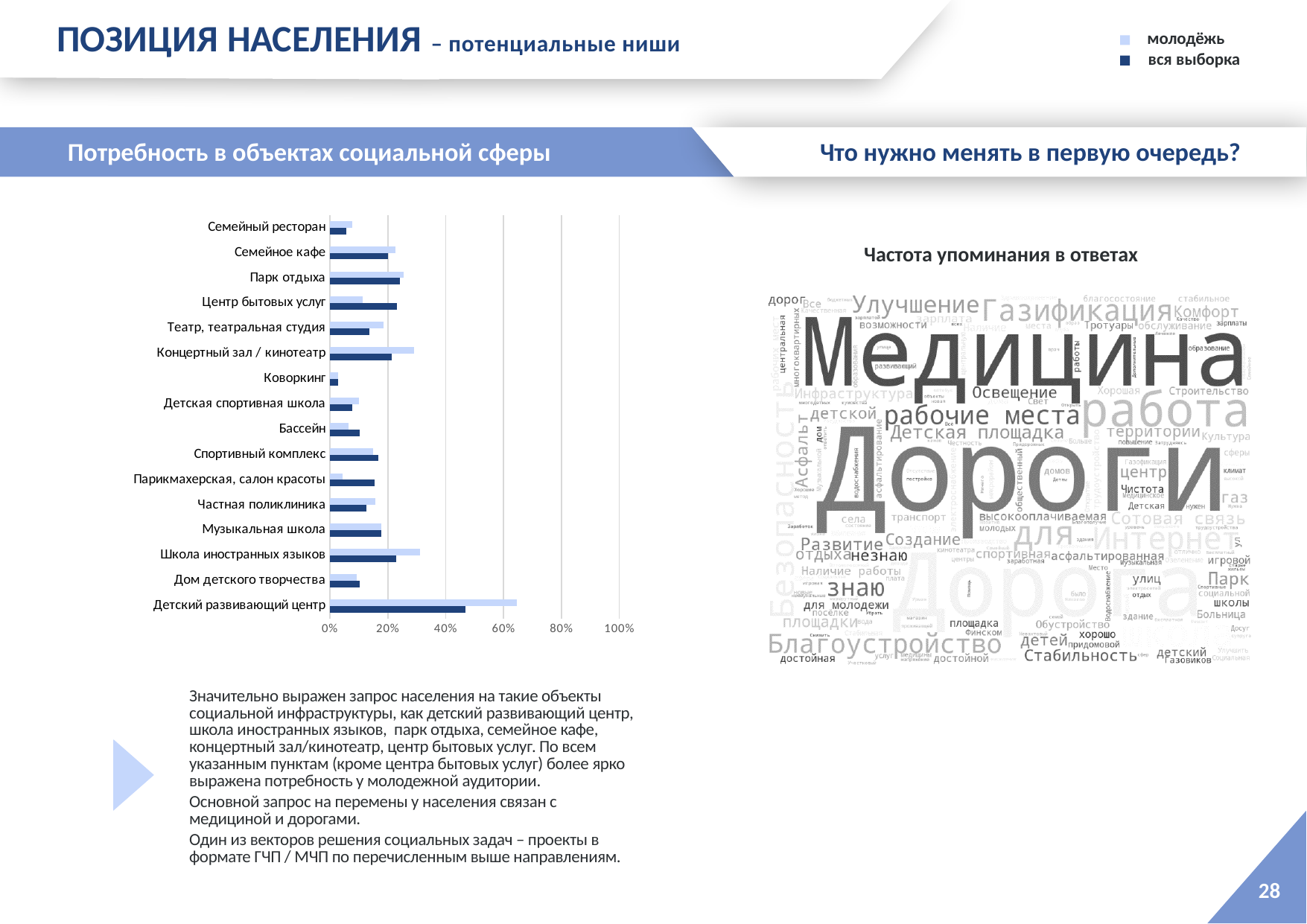
Which category has the highest value for "вся выборка" in the bar chart? Детский развивающий центр For Концертный зал / кинотеатр, which series has the larger value: "молодёжь" or "вся выборка"? молодёжь Is the "вся выборка" value for Детский развивающий центр greater or less than 40%? greater How many categories are shown on the bar chart? 16 What kind of chart is shown under "Потребность в объектах социальной сферы"? bar chart How many series does the legend of the bar chart list? 2 Is the "молодёжь" value for Детский развивающий центр greater or less than 60%? greater For Центр бытовых услуг, which series has the larger value: "молодёжь" or "вся выборка"? вся выборка Which legend entry is shown in the darker blue colour in the bar chart? вся выборка Which category has the lowest value for "вся выборка" in the bar chart? Коворкинг Which category has the highest value for "молодёжь" in the bar chart? Детский развивающий центр Is the "молодёжь" value for Школа иностранных языков greater or less than 20%? greater